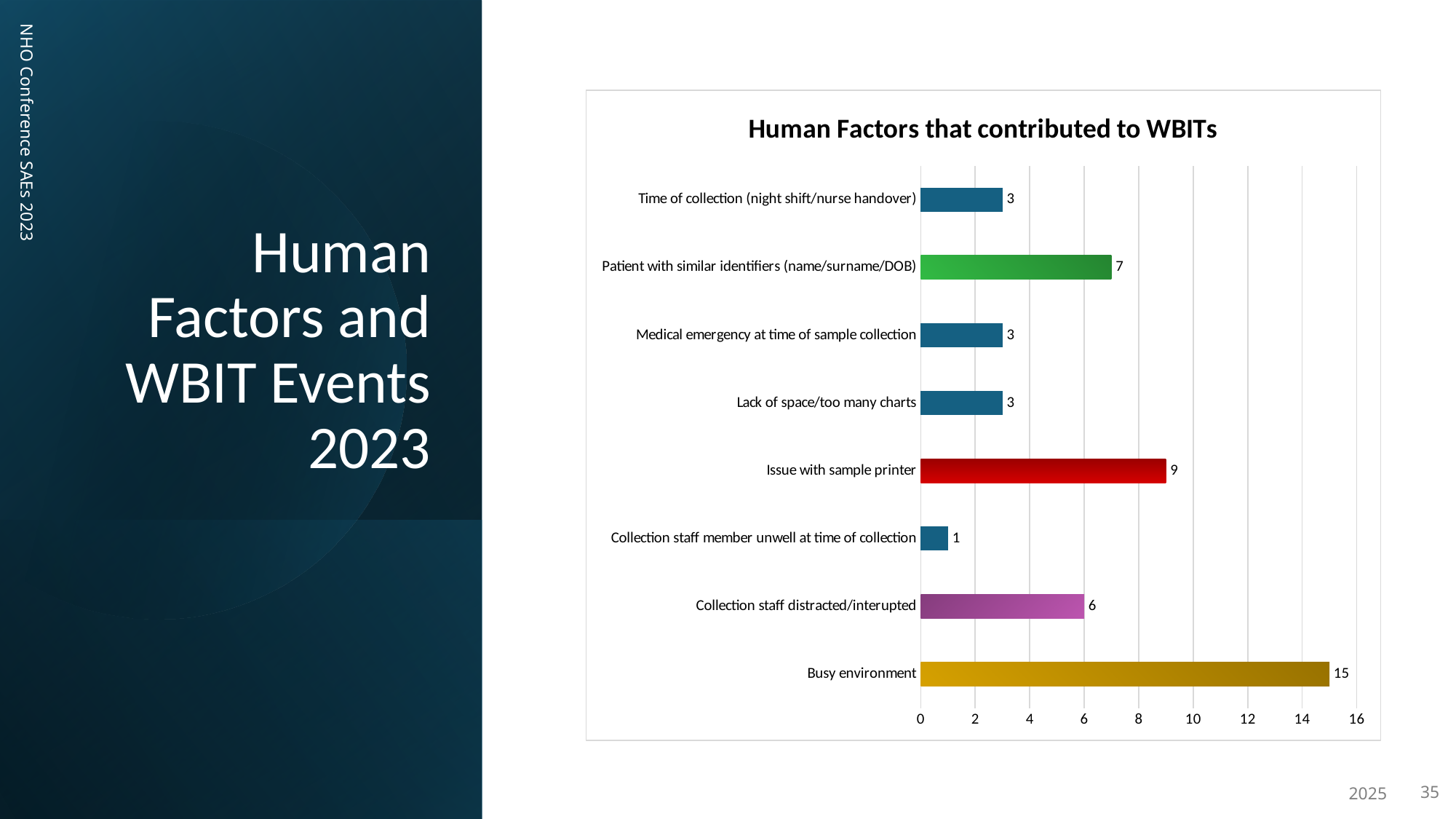
What is the value for Collection staff distracted/interupted? 6 Which is larger, the value for Patient with similar identifiers (name/surname/DOB) or the value for Collection staff distracted/interupted? Patient with similar identifiers (name/surname/DOB) What is the difference between the values for Busy environment and Issue with sample printer? 6 How many categories are shown in the chart? 8 What is the value for Patient with similar identifiers (name/surname/DOB)? 7 Which category has the highest value? Busy environment What is the title of the chart? Human Factors that contributed to WBITs What is the value for Issue with sample printer? 9 What kind of chart is shown on the slide? bar chart What is the value for Busy environment? 15 Is the value for Busy environment greater or less than 14? greater Which category has the lowest value? Collection staff member unwell at time of collection